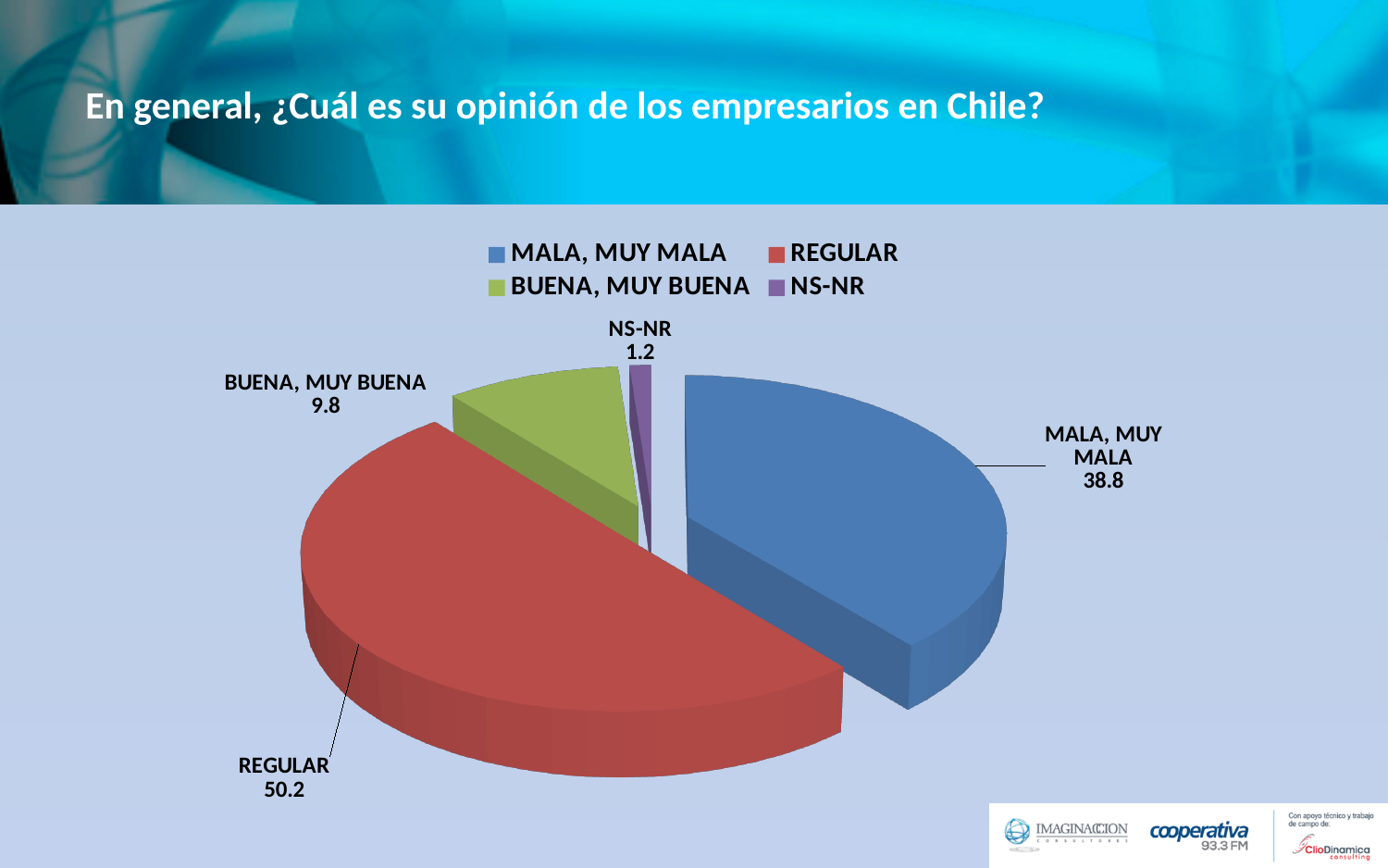
What colour is the REGULAR slice? Red What is the value for NS-NR? 1.2 Which is larger, BUENA, MUY BUENA or NS-NR? BUENA, MUY BUENA What is the difference between the values for REGULAR and MALA, MUY MALA? 11.4 What is the value for BUENA, MUY BUENA? 9.8 What type of chart is shown on the slide? Pie chart Which category has the smallest slice? NS-NR Which category has the largest slice? REGULAR How many categories does the pie chart have? 4 How many entries does the legend list? 4 What is the value for REGULAR? 50.2 What is the value for MALA, MUY MALA? 38.8